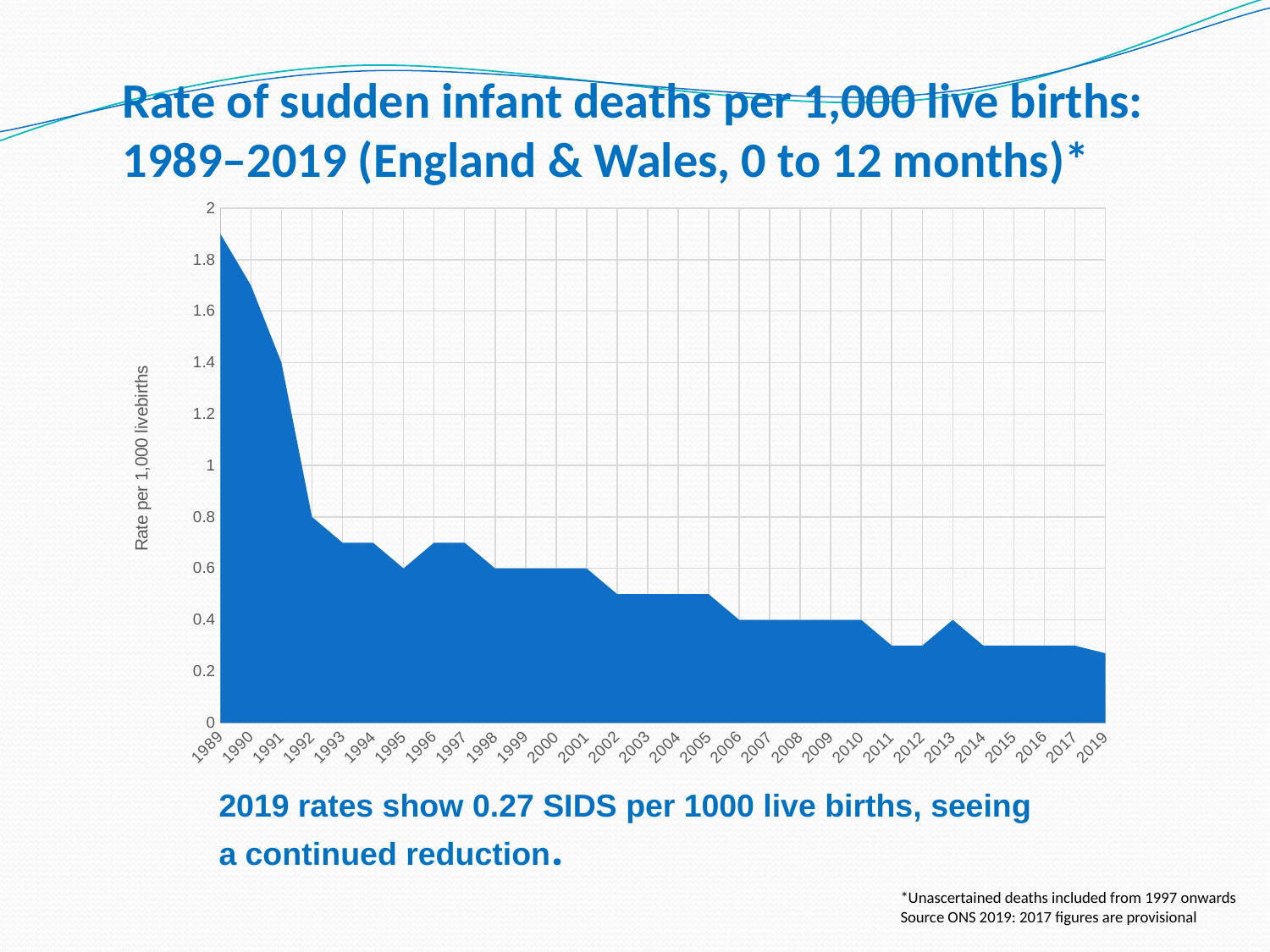
Is the value for 1989 greater or less than 1.8? greater What is the rate per 1,000 live births in 1992? 0.8 Which year has the higher rate, 1996 or 2002? 1996 Which year has the highest rate of sudden infant deaths per 1,000 live births? 1989 What is the rate of sudden infant deaths per 1,000 live births in 2019? 0.27 Which year has the lowest rate of sudden infant deaths per 1,000 live births? 2019 What is the rate per 1,000 live births in 2007? 0.4 What is the label on the vertical axis? Rate per 1,000 livebirths Overall, does the rate rise or fall from 1989 to 2019? Fall What kind of chart is shown on the slide? Area chart Is the value for 2013 greater or less than 0.3? greater Is the value for 2005 greater or less than 0.6? less